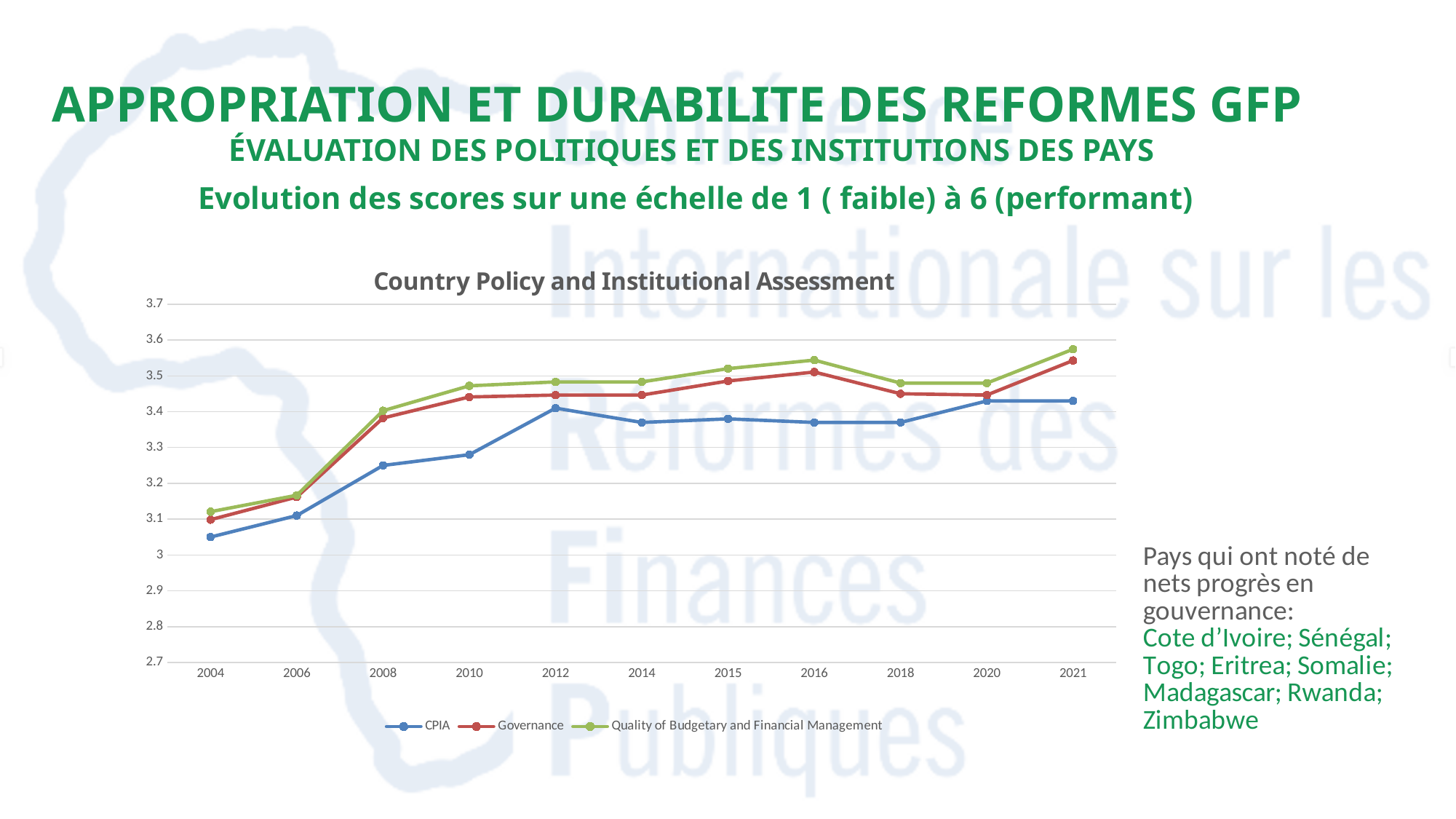
Which series is shown in green in the chart? Quality of Budgetary and Financial Management In which year is the Quality of Budgetary and Financial Management series at its lowest? 2004 Is the CPIA value for 2014 greater or less than 3.4? less What kind of chart is shown on the slide? line chart In 2021, which is larger: the Quality of Budgetary and Financial Management value or the CPIA value? Quality of Budgetary and Financial Management Is the CPIA value for 2004 greater or less than 3? greater How many series does the chart legend list? 3 Is the CPIA value for 2010 greater or less than 3.3? less How many years are plotted along the x axis of the chart? 11 What is the title of the chart? Country Policy and Institutional Assessment Does the CPIA series rise or fall between 2004 and 2012? rise